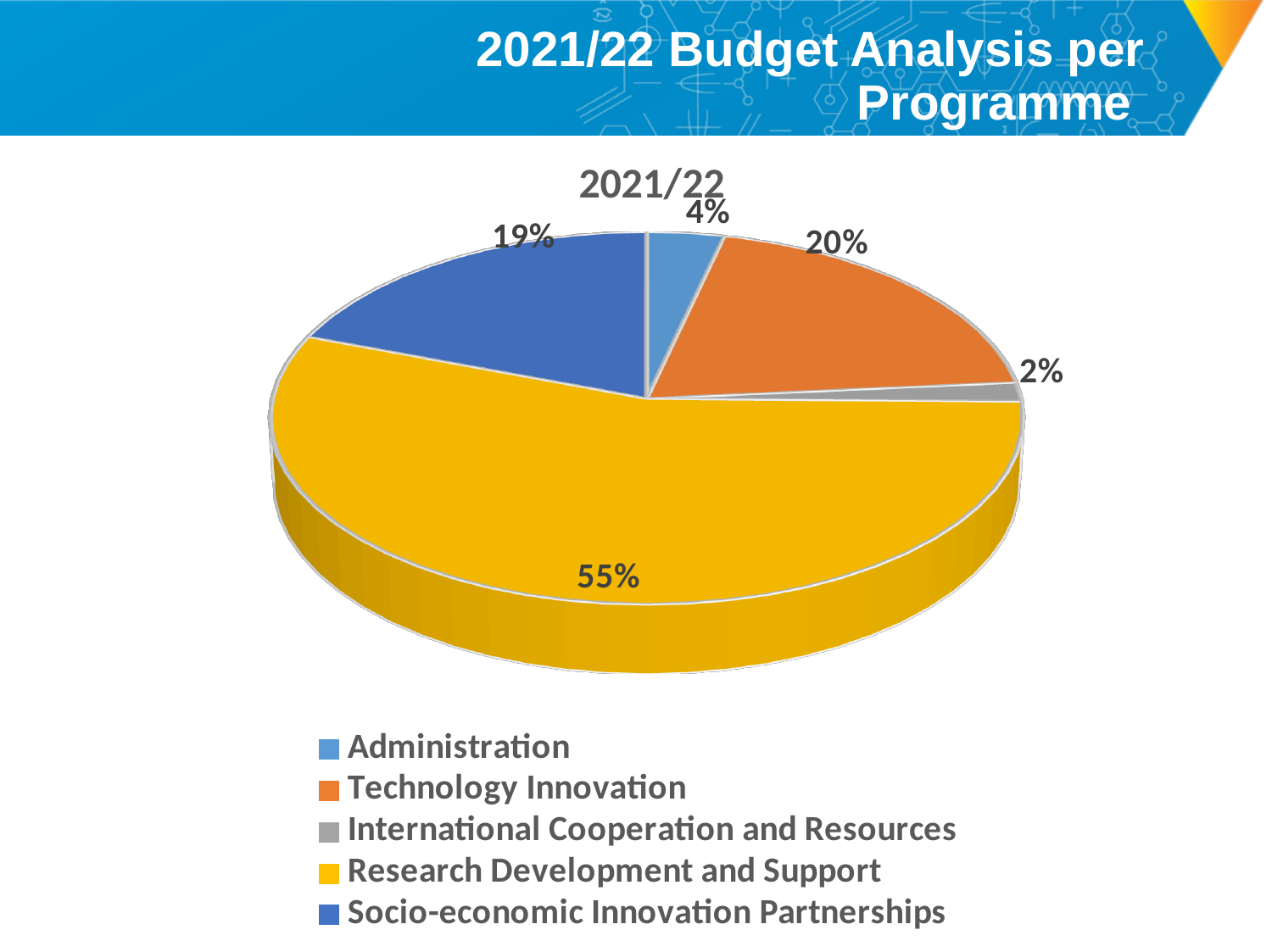
What is the difference in percentage points between the Research Development and Support share and the Technology Innovation share? 35 What type of chart is shown on the slide? Pie chart What share of the 2021/22 budget goes to International Cooperation and Resources? 2% What share of the 2021/22 budget goes to Administration? 4% How many programmes are shown in the pie chart? 5 Which programme has the smallest share of the 2021/22 budget? International Cooperation and Resources What is the title shown above the pie chart? 2021/22 What share of the 2021/22 budget goes to Technology Innovation? 20% Which programme has the largest share of the 2021/22 budget? Research Development and Support Which has a larger share of the budget, Technology Innovation or Socio-economic Innovation Partnerships? Technology Innovation